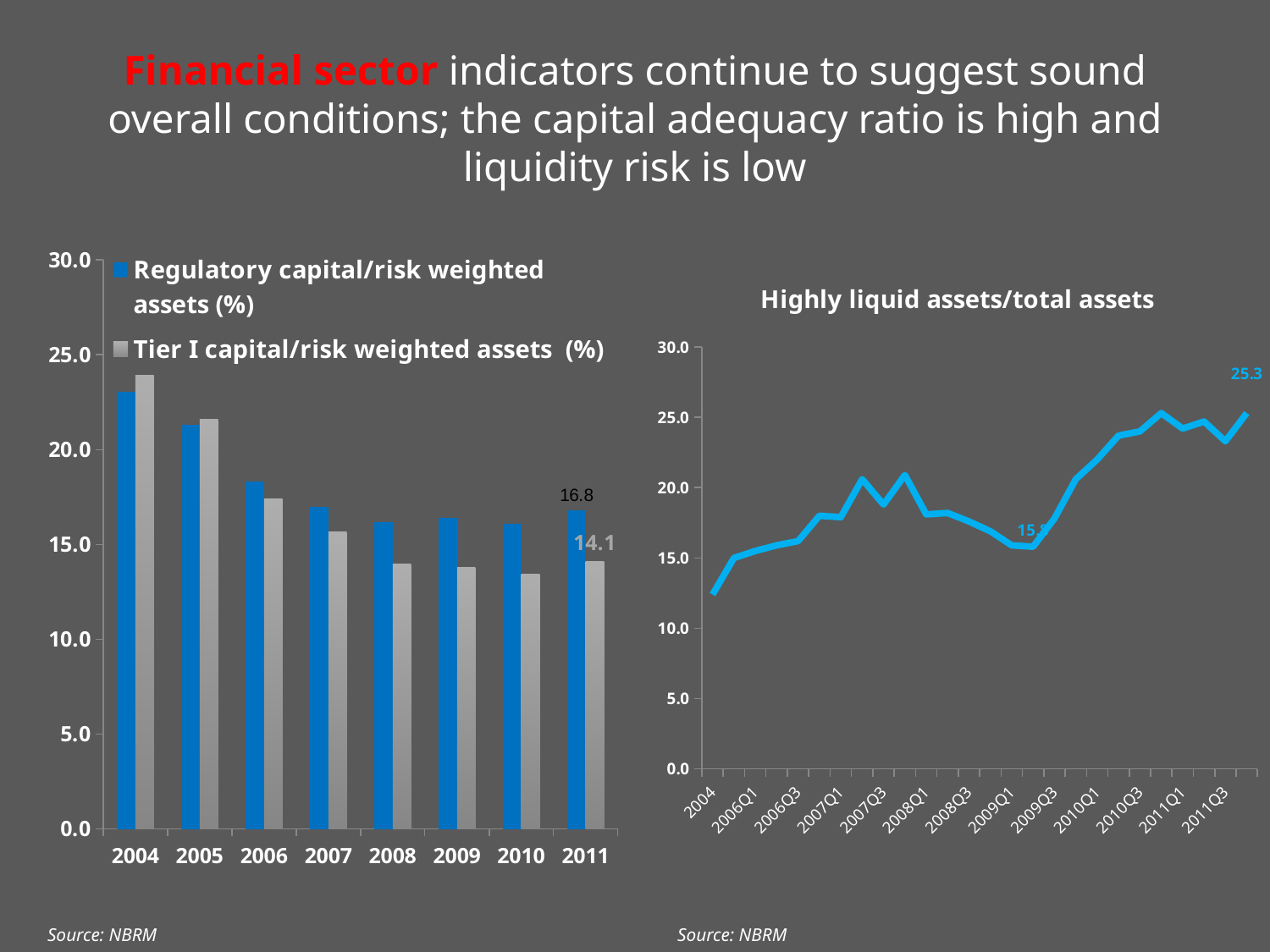
In the left chart, what is the value of Regulatory capital/risk weighted assets (%) for 2011? 16.8 In the left chart, how many years are shown on the x axis? 8 In the left chart, is the Regulatory capital/risk weighted assets (%) value for 2004 greater or less than 20.0? greater In the left chart, is the Tier I capital/risk weighted assets (%) value for 2010 greater or less than 15.0? less In the left chart, what is the difference between the Regulatory capital and Tier I capital ratios in 2011? 2.7 In the left chart, what is the value of Tier I capital/risk weighted assets (%) for 2011? 14.1 In the 'Highly liquid assets/total assets' chart, is the value for 2004 greater or less than 15.0? less In the 'Highly liquid assets/total assets' chart, what is the value labelled at the last point of the line? 25.3 In the left chart, which year has the highest Regulatory capital/risk weighted assets (%) value? 2004 What kind of chart is the 'Highly liquid assets/total assets' chart? line chart What kind of chart is the chart on the left of the slide? bar chart In the left chart, how many series does the legend list? 2